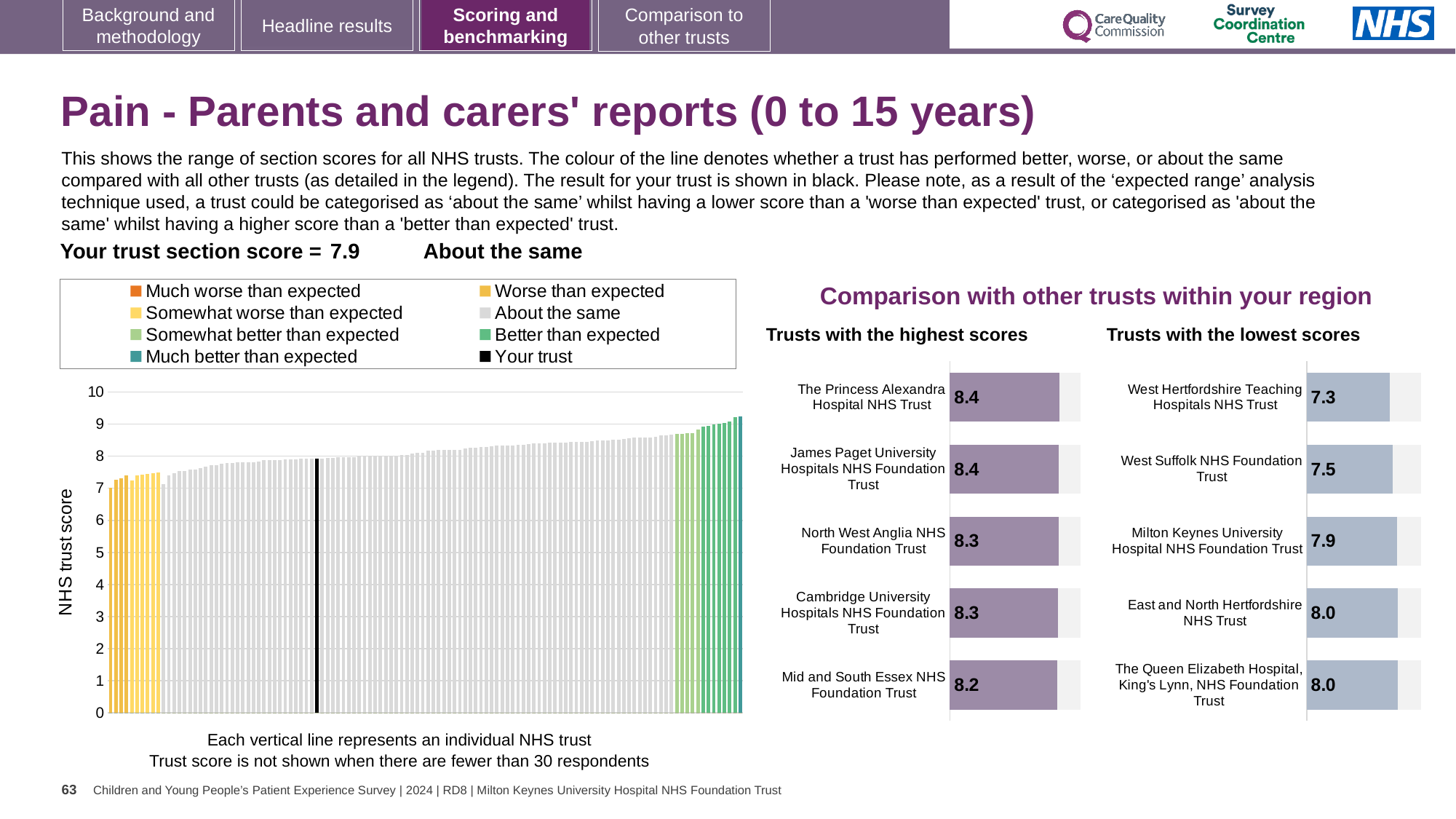
In the 'Trusts with the highest scores' chart, which trust has the lowest score? Mid and South Essex NHS Foundation Trust In the large chart on the left, is the value of the rightmost bar greater or less than 9? greater In the large chart on the left, do the trust scores rise or fall from left to right? rise In the 'Trusts with the lowest scores' chart, which has the higher score: Milton Keynes University Hospital NHS Foundation Trust or West Suffolk NHS Foundation Trust? Milton Keynes University Hospital NHS Foundation Trust In the 'Trusts with the highest scores' chart, what is the difference between the scores of The Princess Alexandra Hospital NHS Trust and Mid and South Essex NHS Foundation Trust? 0.2 What kind of chart is the large chart on the left with the y axis labelled 'NHS trust score'? bar chart In the 'Trusts with the lowest scores' chart, how many trusts are shown? 5 In the 'Trusts with the lowest scores' chart, which trust has the lowest score? West Hertfordshire Teaching Hospitals NHS Trust In the large chart on the left, is the value of the leftmost bar greater or less than 8? less In the large chart on the left, what colour is the bar for 'Your trust'? black In the large chart on the left, how many entries does the legend list? 8 In the 'Trusts with the highest scores' chart, what is the score for North West Anglia NHS Foundation Trust? 8.3